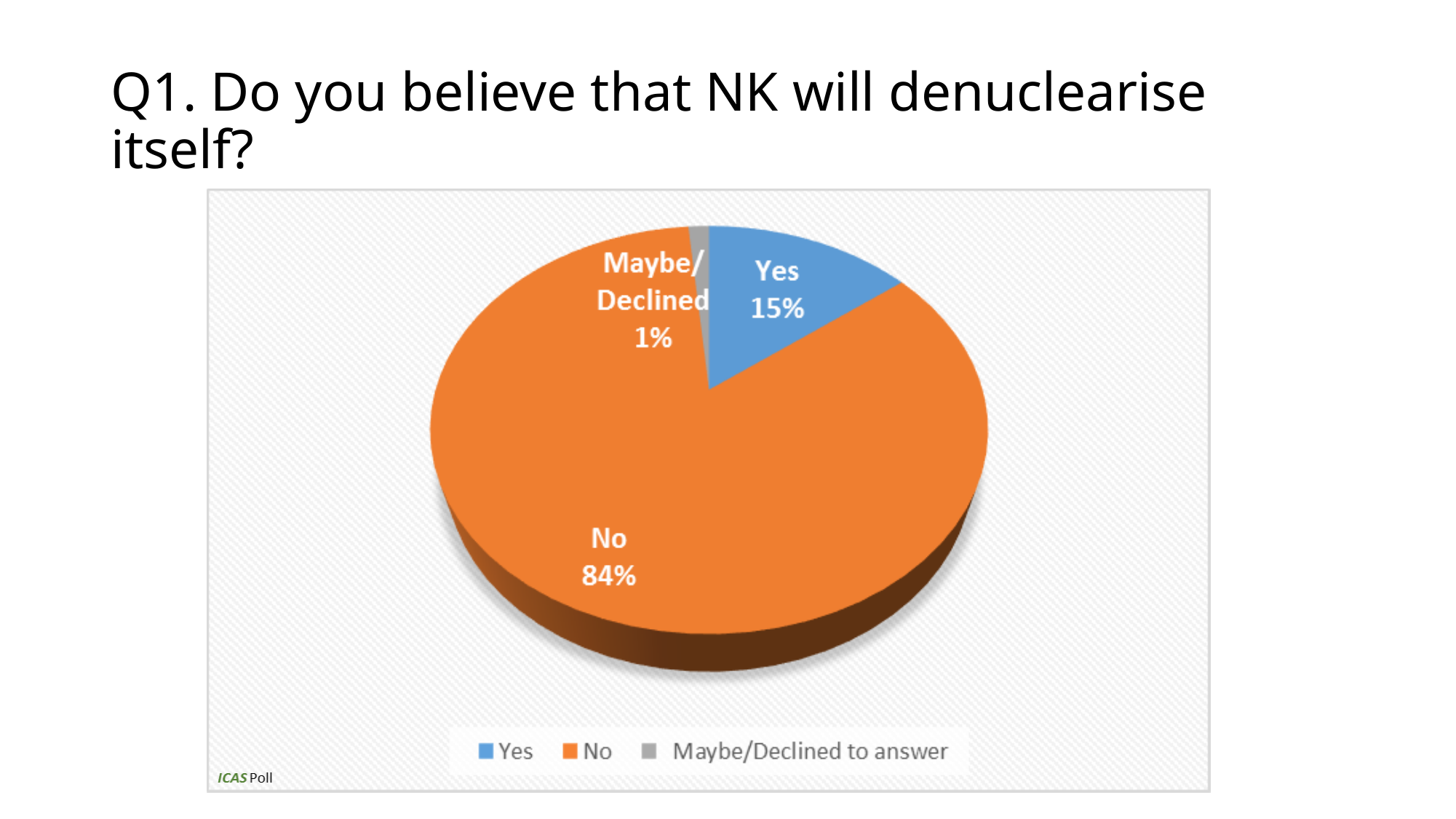
How many slices does the pie chart have? 3 What colour is the "No" slice? Orange What percentage of respondents answered "Maybe/Declined to answer"? 1% Which response has the smallest share of the pie? Maybe/Declined to answer What kind of chart is shown on the slide? Pie chart Which is larger, the share for "Yes" or the share for "Maybe/Declined to answer"? Yes What percentage of respondents answered "Yes"? 15% What percentage of respondents answered "No"? 84% How many entries does the legend list? 3 What is the source noted in the bottom-left corner of the chart? ICAS Poll Which response has the largest share of the pie? No What is the difference in percentage points between the "No" and "Yes" responses? 69